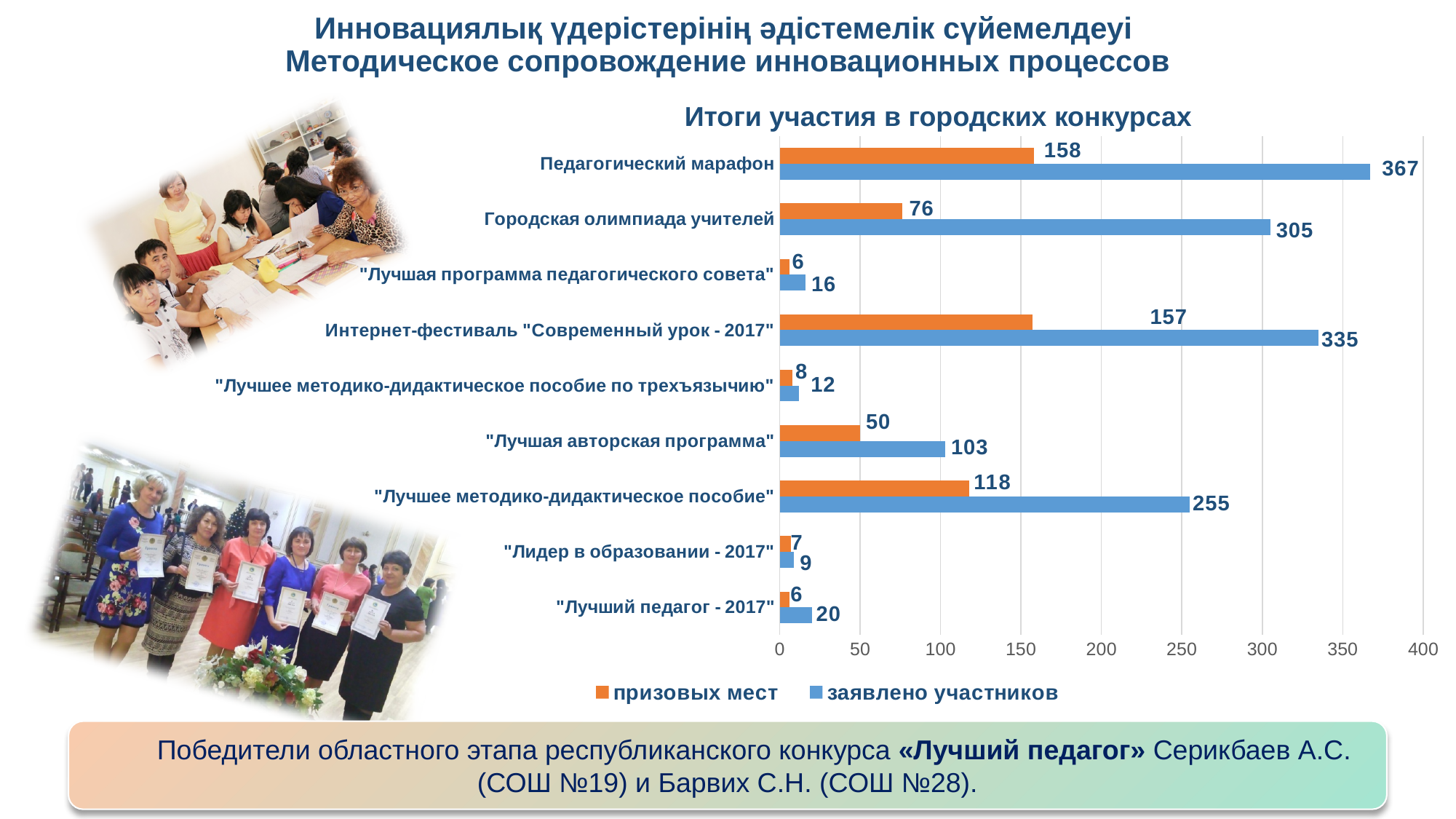
What is the value of заявлено участников for "Лучшая авторская программа"? 103 What is the title of the chart? Итоги участия в городских конкурсах Is the value of заявлено участников for Городская олимпиада учителей greater or less than 300? greater What is the difference between заявлено участников and призовых мест for Интернет-фестиваль "Современный урок - 2017"? 178 How many prize places (призовых мест) were won in Городская олимпиада учителей? 76 How many participants were declared (заявлено участников) for Педагогический марафон? 367 Which is larger: призовых мест for Педагогический марафон or for "Лучшее методико-дидактическое пособие"? Педагогический марафон Which category has the lowest number of заявлено участников? "Лидер в образовании - 2017" Which category has the highest number of заявлено участников? Педагогический марафон How many series does the legend list? 2 How many categories (competitions) are shown in the chart? 9 What type of chart is shown on the slide? Bar chart